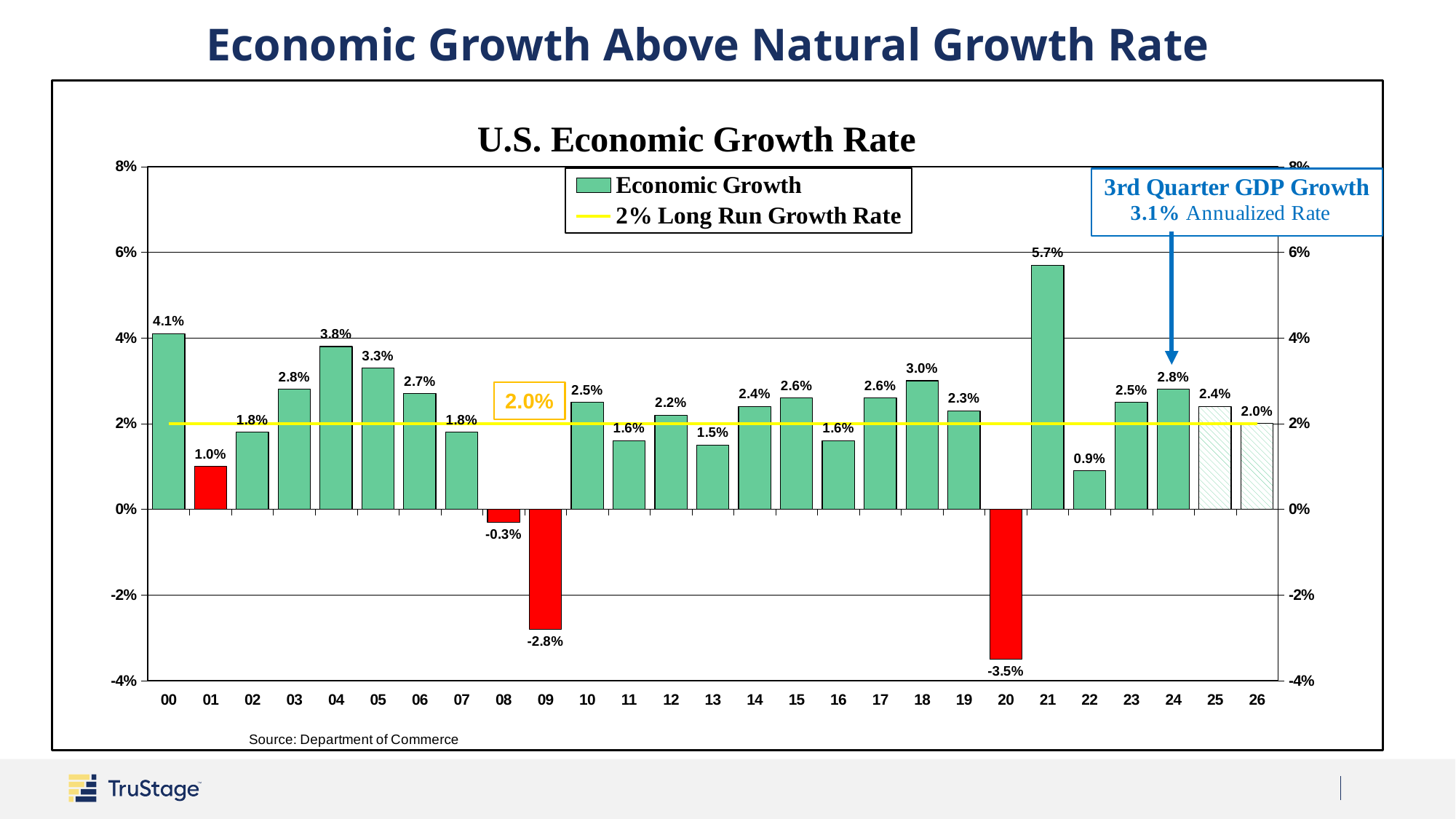
Is the economic growth rate for 2021 greater or less than 4%? greater Which year has the highest economic growth rate on the chart? 21 What is the economic growth rate shown for 2021 (labelled 21)? 5.7% What is the economic growth rate shown for 2009 (labelled 09)? -2.8% What is the difference between the economic growth rate in 2021 (5.7%) and in 2000 (4.1%)? 1.6 percentage points What is the economic growth rate shown for 2018 (labelled 18)? 3.0% What kind of chart is used to show the U.S. Economic Growth Rate? Combination bar and line chart (bars for economic growth with a line for the 2% long run growth rate) Which year has the lowest economic growth rate on the chart? 20 How many years are shown on the x axis of the chart? 27 What 3rd Quarter GDP Growth annualized rate is called out in the box on the chart? 3.1% How many series does the legend list? 2 Which year has the higher economic growth rate, 04 or 05? 04